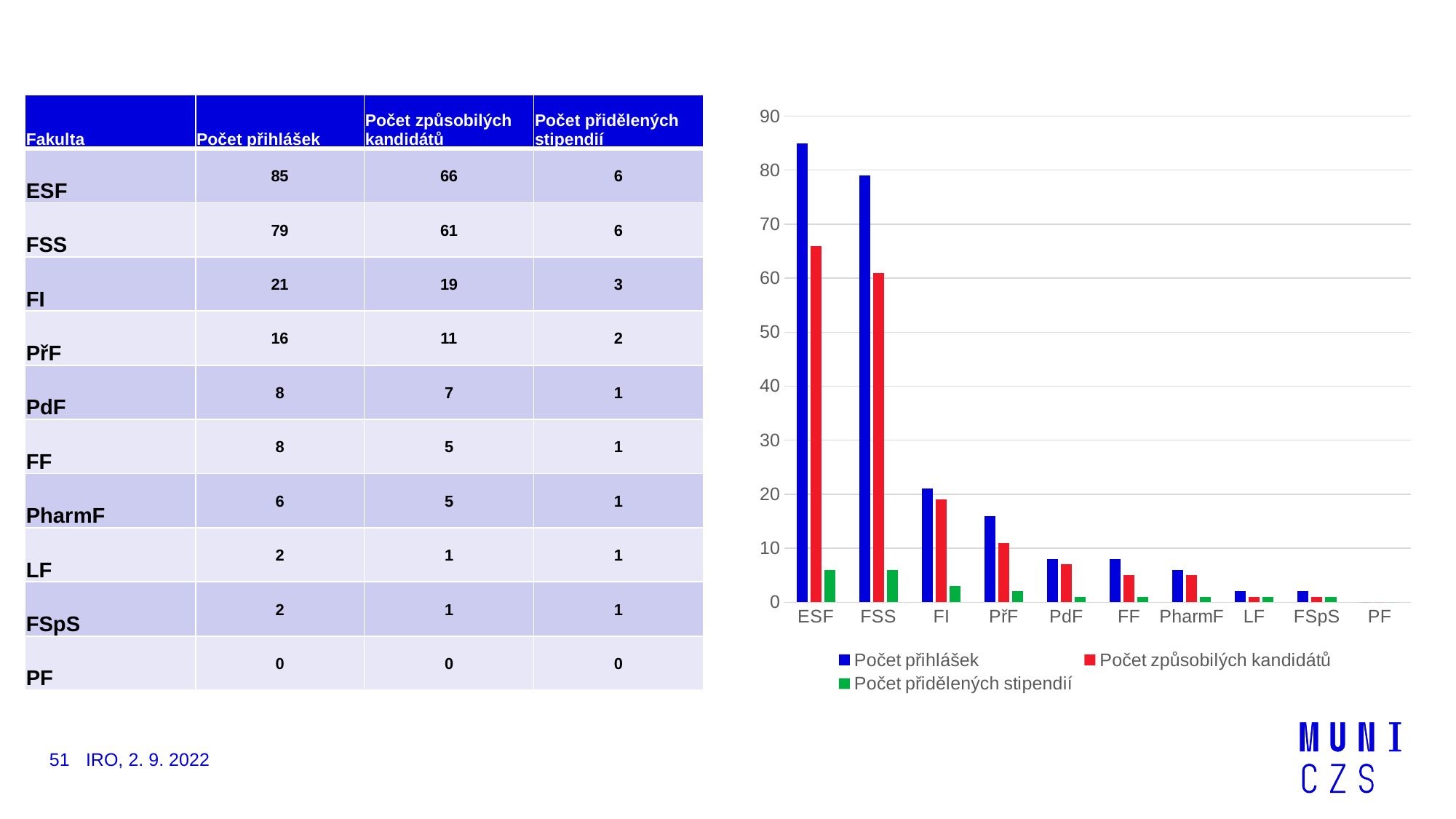
What is the difference between Počet přihlášek for ESF and Počet přihlášek for FSS? 6 Is the value of Počet přihlášek for ESF greater or less than 80? greater Which faculty has the highest value for Počet přihlášek? ESF How many faculties are shown on the x axis of the chart? 10 Which is larger: Počet přihlášek for FI or Počet přihlášek for PřF? FI What kind of chart is shown on the slide? bar chart What is the value of Počet přihlášek for FSS? 79 Is the value of Počet způsobilých kandidátů for FI greater or less than 20? less What is the value of Počet přidělených stipendií for FI? 3 How many series does the chart legend list? 3 What is the value of Počet způsobilých kandidátů for ESF? 66 Which faculty has the lowest value for Počet přihlášek? PF